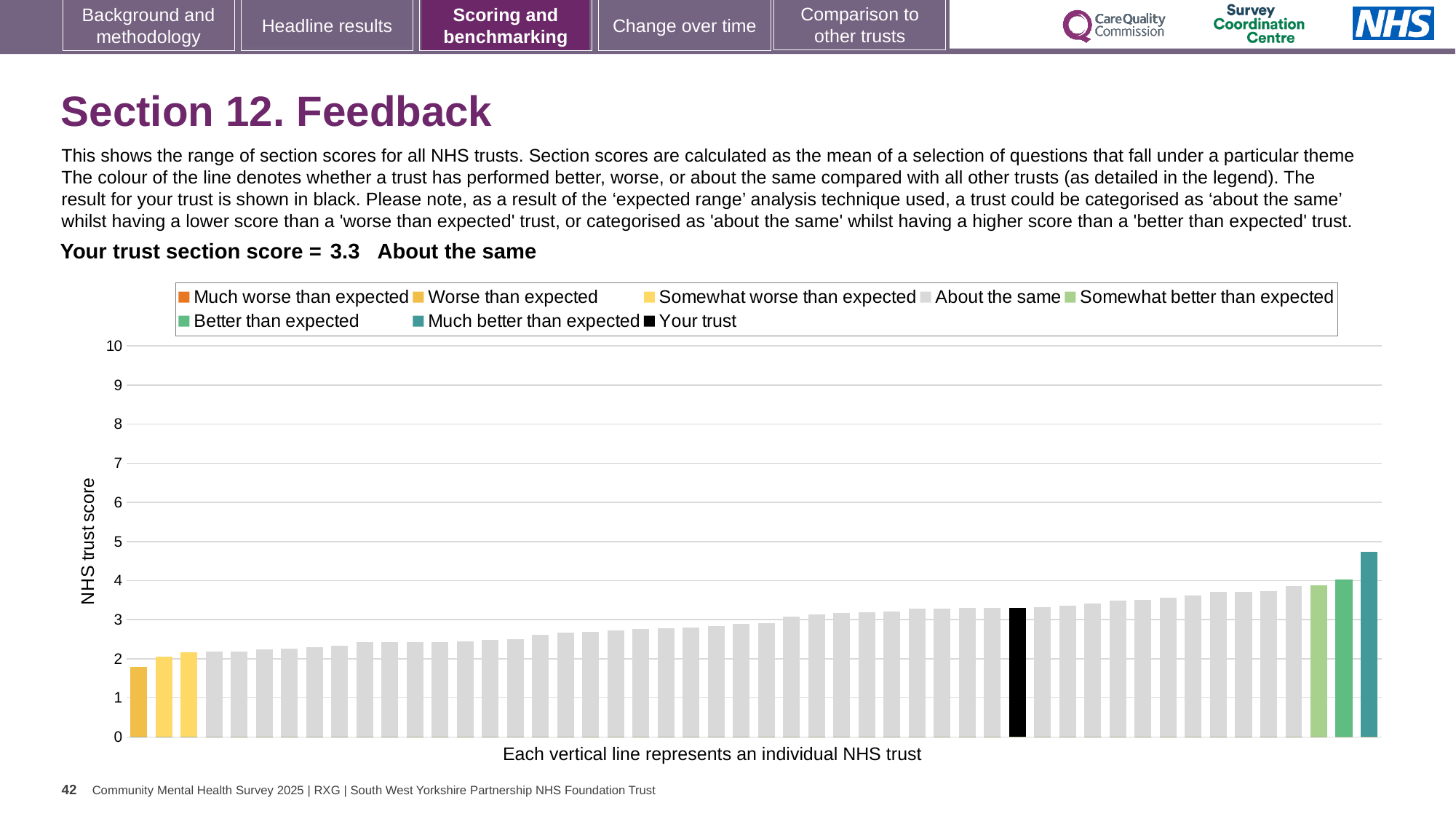
Is the value of the tallest bar greater or less than 4? greater What is the title of the vertical axis? NHS trust score Is the value of the shortest bar greater or less than 2? less What kind of chart is shown on the slide? bar chart Is the value of the tallest bar greater or less than 5? less Which legend category does the tallest bar belong to? Much better than expected How many entries does the chart legend list? 8 Which category is your trust placed in for this section? About the same What is the section score for your trust? 3.3 Do the bar values rise or fall from left to right along the x axis? rise